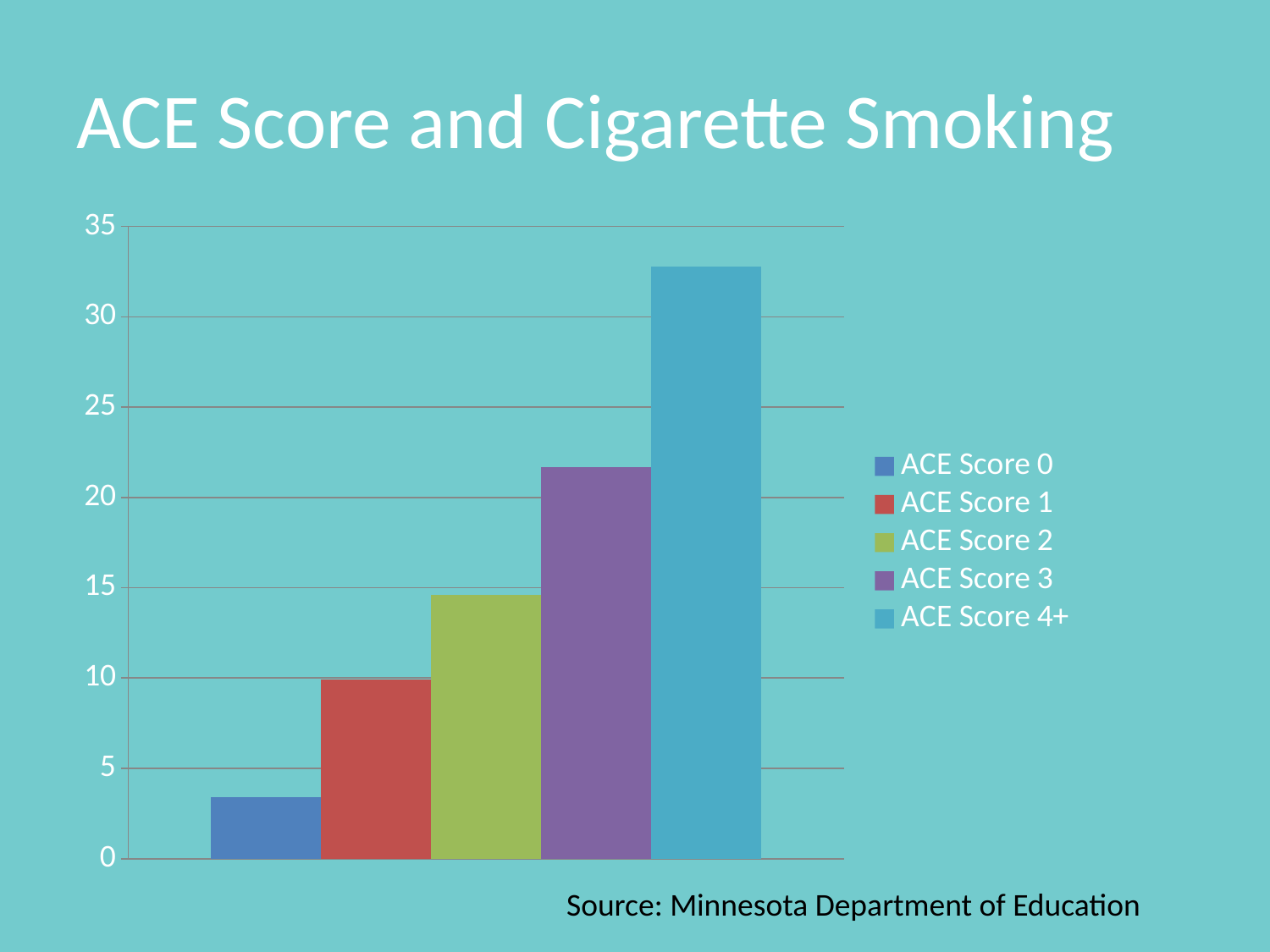
Is the value for ACE Score 0 greater or less than 5? less How many series does the legend list? 5 Is the value for ACE Score 3 greater or less than 20? greater What kind of chart is shown on the slide? bar chart Which series has the highest value? ACE Score 4+ Is the value for ACE Score 3 greater or less than 25? less Which series has the lowest value? ACE Score 0 What is the title of the chart? ACE Score and Cigarette Smoking Which is larger, the value for ACE Score 2 or the value for ACE Score 3? ACE Score 3 Do the values rise or fall as the ACE score increases from 0 to 4+? rise